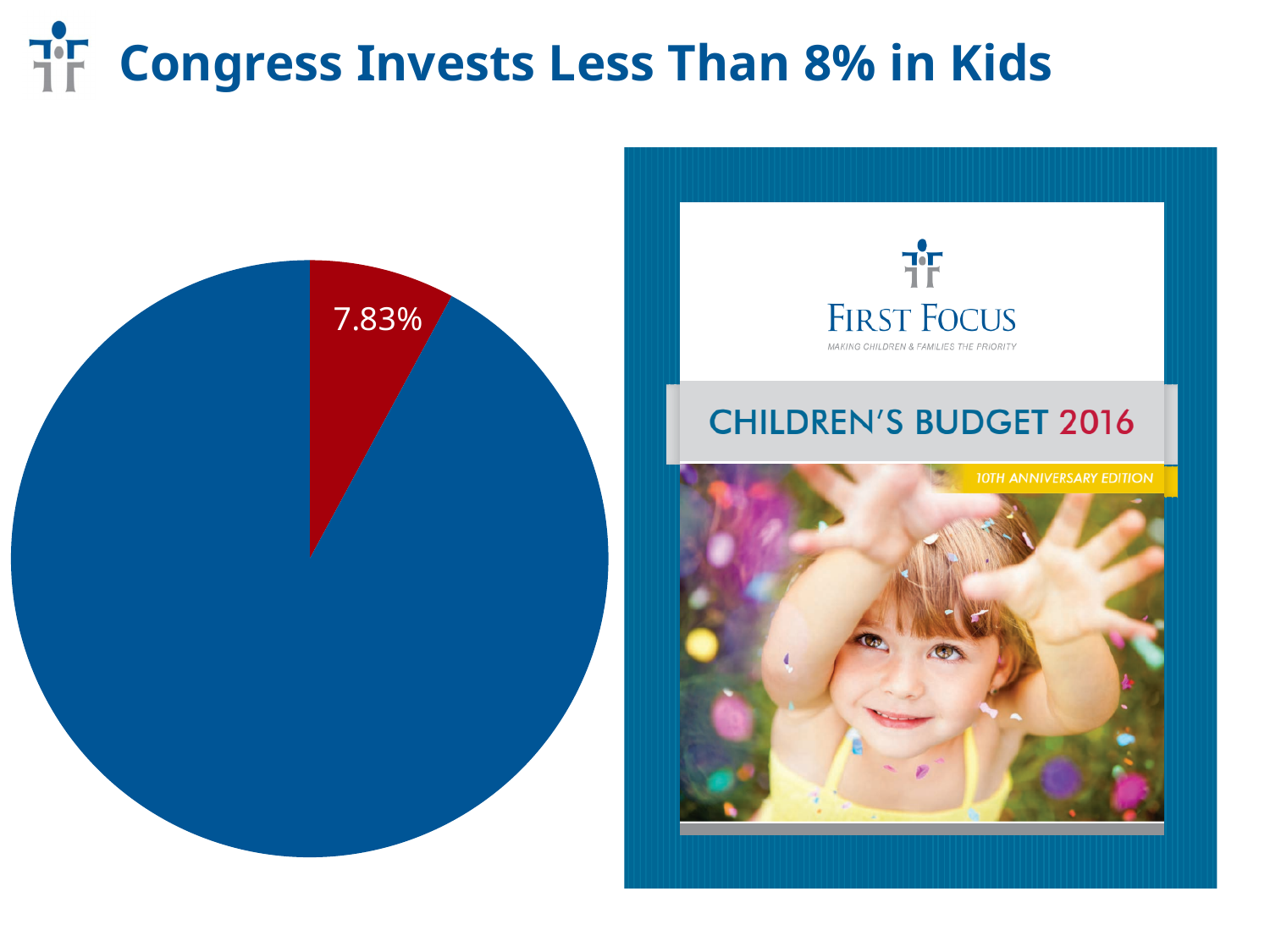
What value is printed on the red slice of the pie chart? 7.83% What colour is the slice that carries the 7.83% data label? red Which slice of the pie chart is the smallest? the red slice How many slices of the pie chart have a printed data label? 1 What is the title of the slide containing the pie chart? Congress Invests Less Than 8% in Kids Which slice of the pie chart is the largest? the blue slice What kind of chart is shown on the slide? pie chart Which slice of the pie chart is larger, the red slice or the blue slice? the blue slice What share of the pie does the red slice represent? 7.83% How many slices does the pie chart have? 2